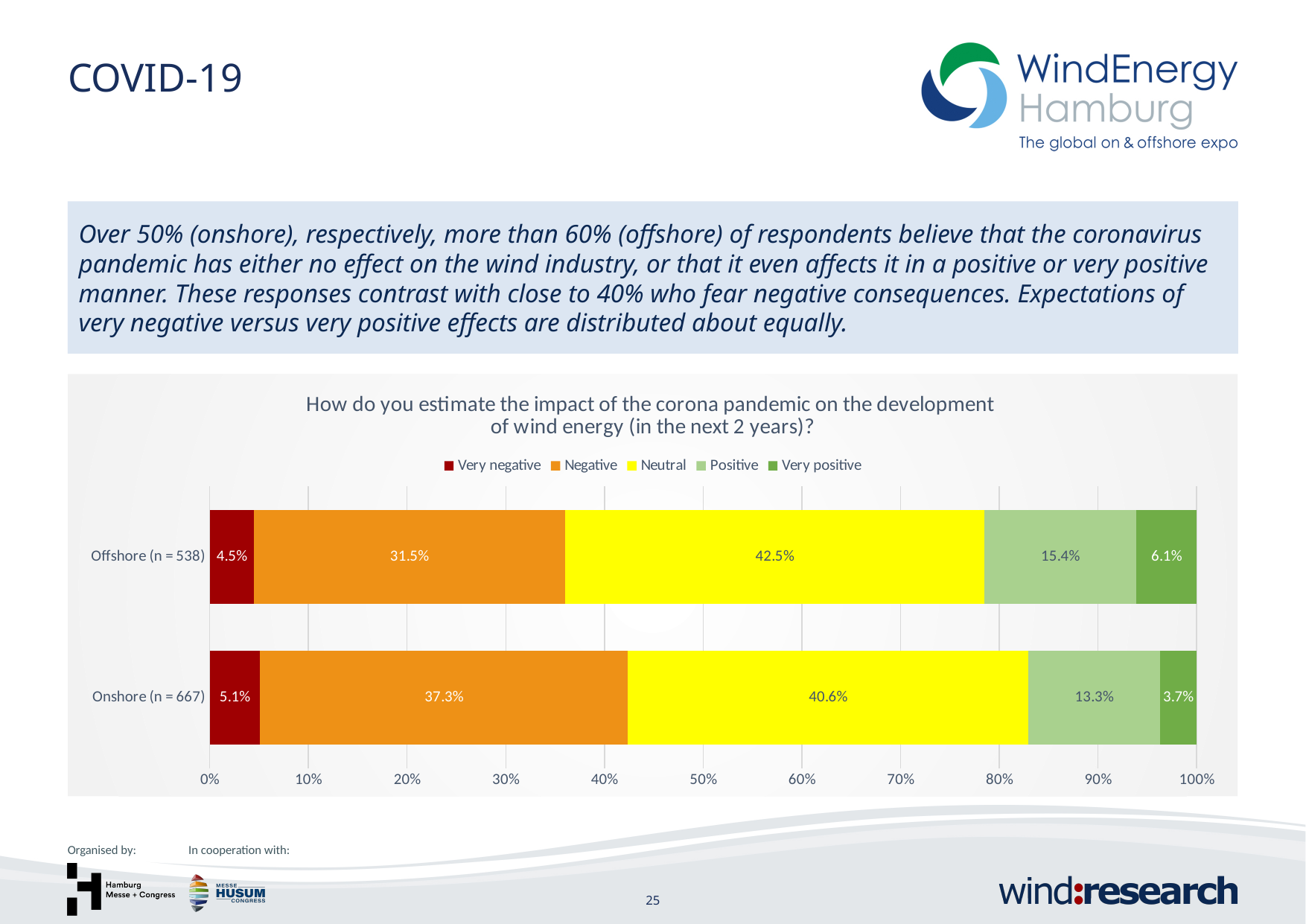
How many series does the legend list? 5 What is the Very positive value for Onshore (n = 667)? 3.7% What percentage of Offshore respondents answered Neutral? 42.5% What is the Positive value for Offshore (n = 538)? 15.4% What percentage of Onshore respondents answered Negative? 37.3% Which response category has the largest share for Onshore respondents? Neutral What is the combined share of Positive and Very positive responses for Offshore? 21.5% How many groups (bars) are shown in the chart? 2 Which response category has the smallest share for Offshore respondents? Very negative Which group has a larger Very positive share, Offshore or Onshore? Offshore What kind of chart is shown on the slide? Stacked bar chart What is the difference between the Negative shares for Onshore and Offshore? 5.8%